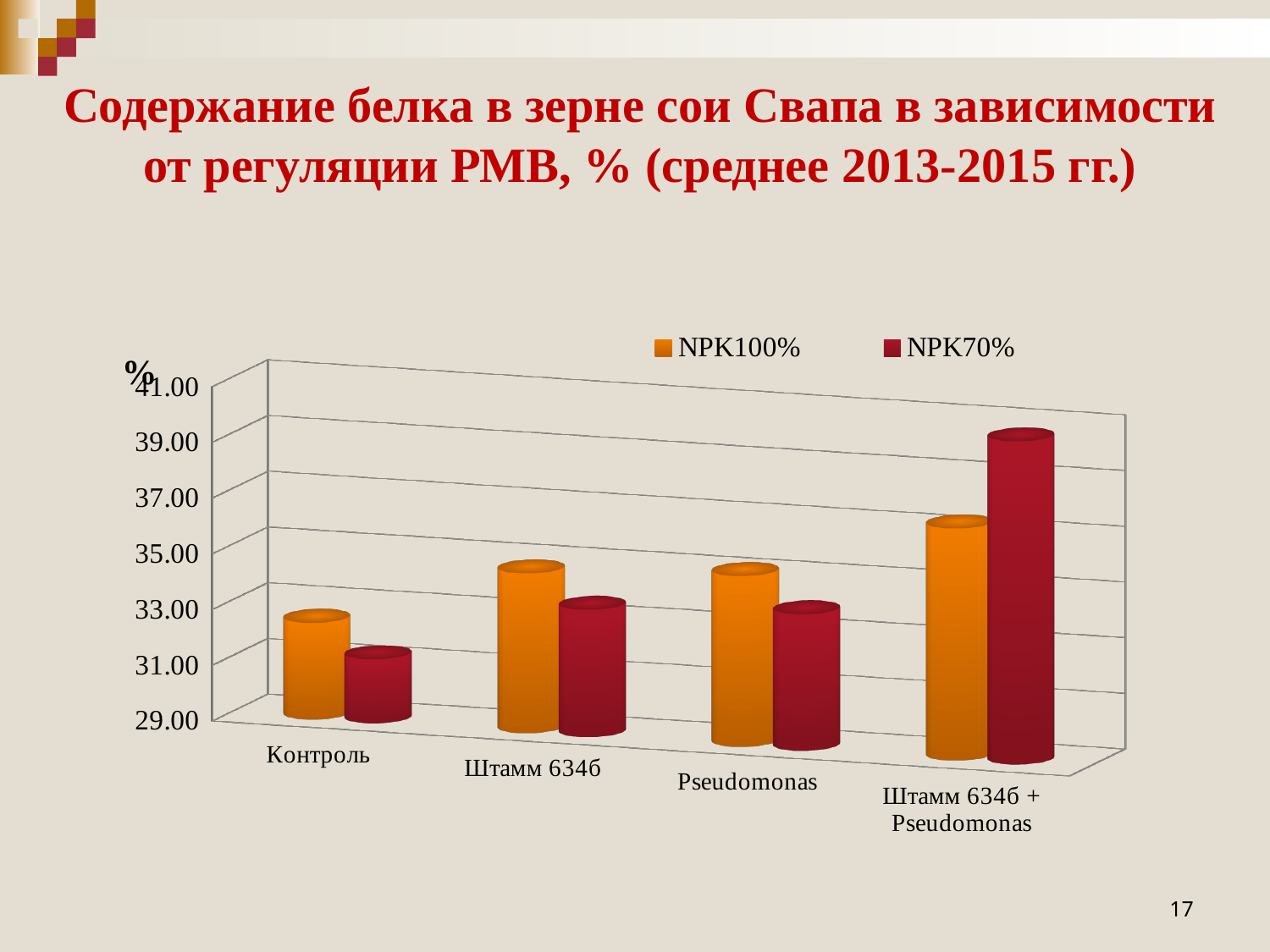
Which category has the lowest NPK70% value? Контроль What kind of chart is shown on the slide? bar chart Which colour represents the NPK70% series in the legend? dark red Which category has the highest NPK70% value? Штамм 634б + Pseudomonas How many series does the legend list? 2 Which category has the lowest NPK100% value? Контроль Is the NPK70% value for Контроль greater or less than 33.00? less For Контроль, which series has the larger value, NPK100% or NPK70%? NPK100% Is the NPK100% value for Штамм 634б + Pseudomonas greater or less than 35.00? greater For Штамм 634б + Pseudomonas, which series has the larger value, NPK100% or NPK70%? NPK70% Is the NPK70% value for Штамм 634б + Pseudomonas greater or less than 37.00? greater How many categories are shown on the x axis? 4